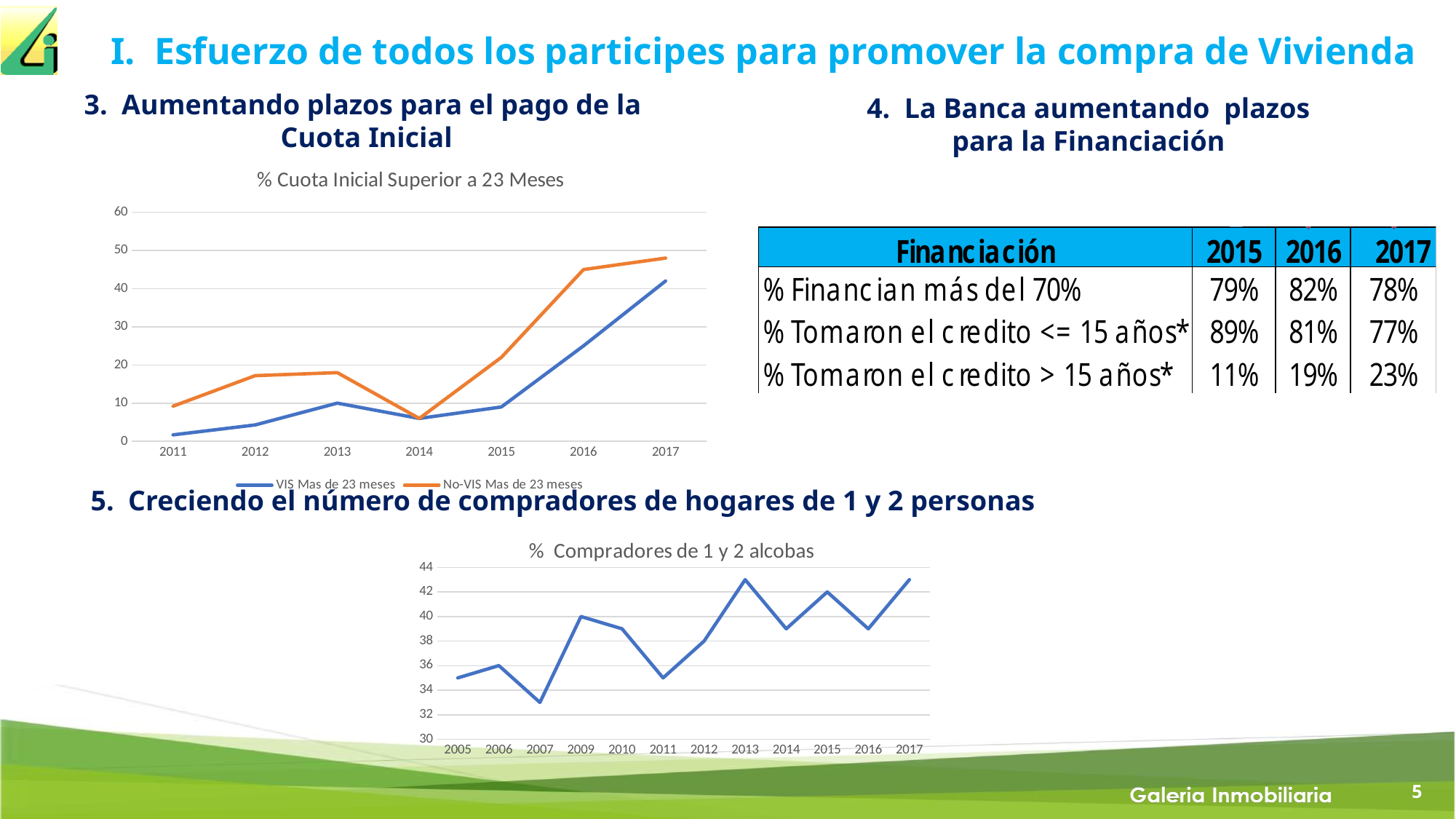
On the chart titled '% Cuota Inicial Superior a 23 Meses', is the value for 'No-VIS Mas de 23 meses' in 2017 greater or less than 40? greater On the chart titled '% Cuota Inicial Superior a 23 Meses', what are the two legend entries? VIS Mas de 23 meses; No-VIS Mas de 23 meses On the chart titled '% Compradores de 1 y 2 alcobas', is the value for 2013 greater or less than 42? greater On the chart titled '% Compradores de 1 y 2 alcobas', which year has the lowest value? 2007 On the chart titled '% Cuota Inicial Superior a 23 Meses', which series has the higher value in 2016? No-VIS Mas de 23 meses On the chart titled '% Cuota Inicial Superior a 23 Meses', does the 'VIS Mas de 23 meses' series rise or fall from 2014 to 2017? rise On the chart titled '% Cuota Inicial Superior a 23 Meses', how many series does the legend list? 2 On the chart titled '% Cuota Inicial Superior a 23 Meses', is the value for 'VIS Mas de 23 meses' in 2011 greater or less than 10? less On the chart titled '% Compradores de 1 y 2 alcobas', how many years are shown on the x axis? 12 On the chart titled '% Compradores de 1 y 2 alcobas', what kind of chart is shown? line chart On the chart titled '% Cuota Inicial Superior a 23 Meses', what kind of chart is shown? line chart On the chart titled '% Cuota Inicial Superior a 23 Meses', how many years are shown on the x axis? 7